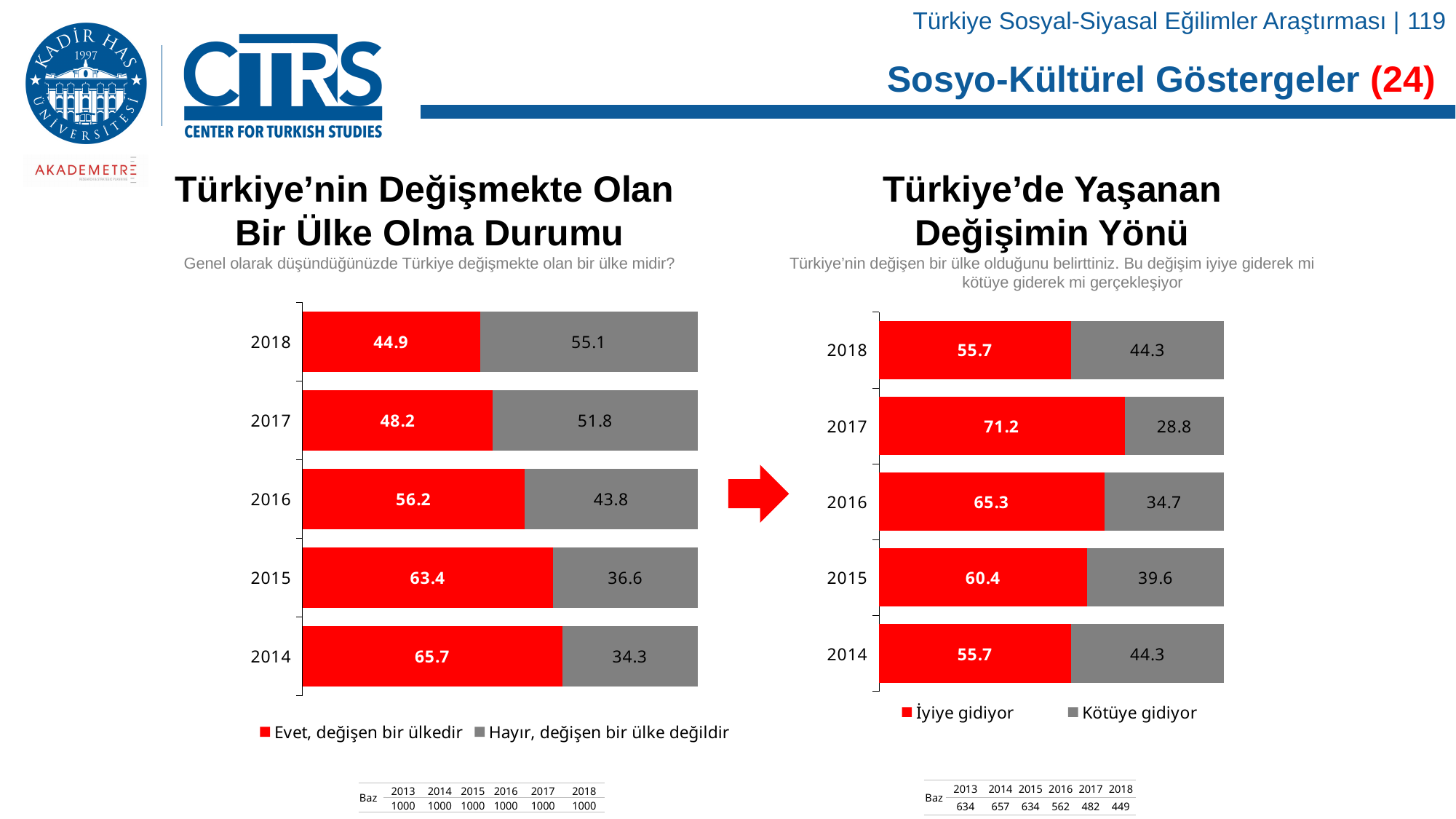
In the right chart (Türkiye'de Yaşanan Değişimin Yönü), which year has the highest value for 'İyiye gidiyor'? 2017 In the left chart (Türkiye'nin Değişmekte Olan Bir Ülke Olma Durumu), what is the difference between the 'Evet, değişen bir ülkedir' values for 2014 and 2018? 20.8 In the right chart (Türkiye'de Yaşanan Değişimin Yönü), what is the value for 'Kötüye gidiyor' in 2015? 39.6 In the right chart (Türkiye'de Yaşanan Değişimin Yönü), which is larger: the 'İyiye gidiyor' value for 2016 or for 2015? 2016 In the left chart (Türkiye'nin Değişmekte Olan Bir Ülke Olma Durumu), does the 'Evet, değişen bir ülkedir' value rise or fall from 2014 to 2018? fall In the left chart (Türkiye'nin Değişmekte Olan Bir Ülke Olma Durumu), which year has the highest value for 'Evet, değişen bir ülkedir'? 2014 In the left chart (Türkiye'nin Değişmekte Olan Bir Ülke Olma Durumu), what is the value for 'Hayır, değişen bir ülke değildir' in 2016? 43.8 In the left chart (Türkiye'nin Değişmekte Olan Bir Ülke Olma Durumu), what is the value for 'Evet, değişen bir ülkedir' in 2018? 44.9 In the right chart (Türkiye'de Yaşanan Değişimin Yönü), what is the value for 'İyiye gidiyor' in 2017? 71.2 How many series does the legend of the left chart (Türkiye'nin Değişmekte Olan Bir Ülke Olma Durumu) list? 2 How many years are shown in the right chart (Türkiye'de Yaşanan Değişimin Yönü)? 5 In the left chart (Türkiye'nin Değişmekte Olan Bir Ülke Olma Durumu), which year has the lowest value for 'Evet, değişen bir ülkedir'? 2018